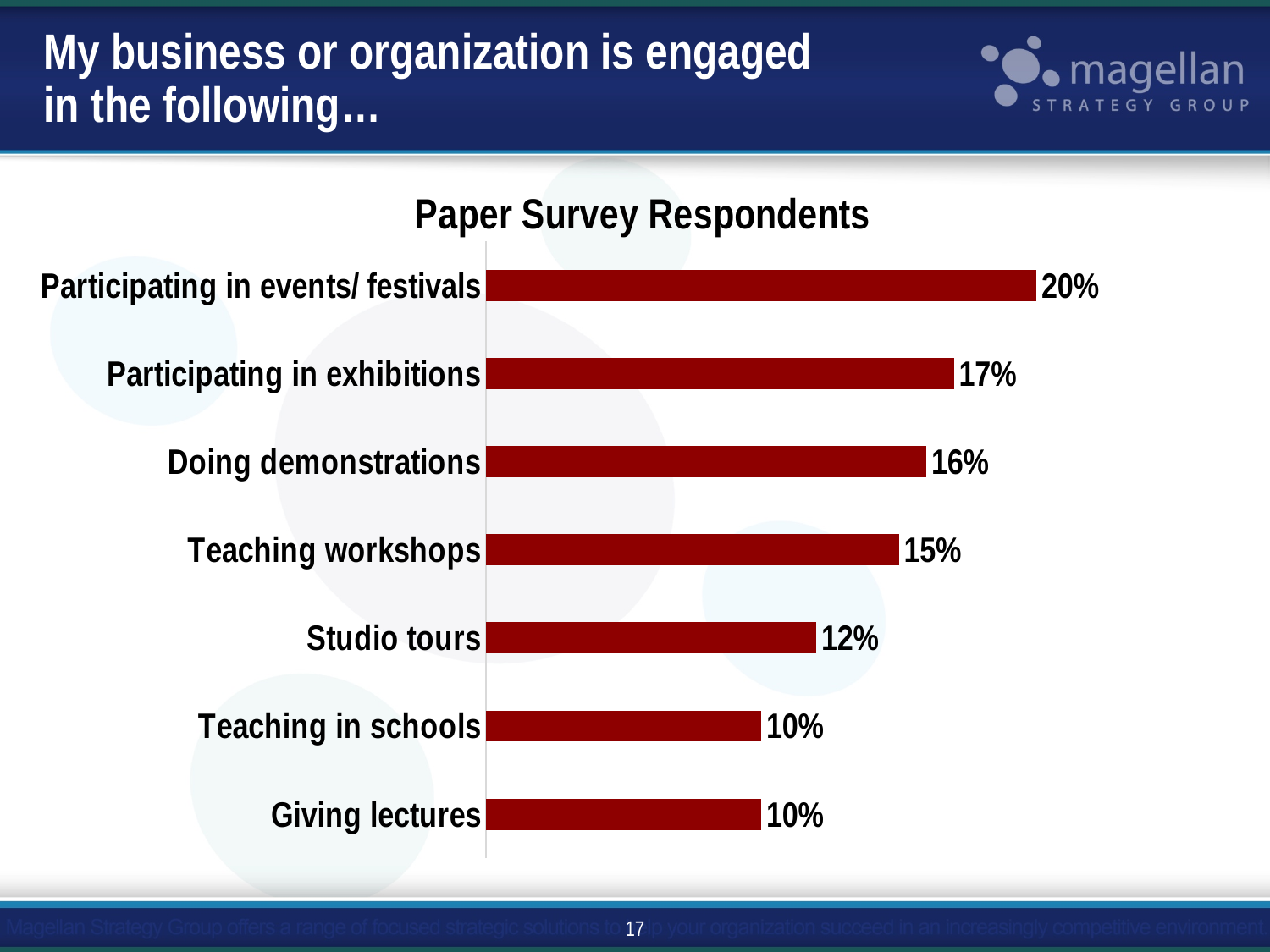
What is the difference between Participating in events/ festivals and Giving lectures? 10% What is the difference between Participating in exhibitions and Teaching workshops? 2% What percentage of paper survey respondents are engaged in participating in events/ festivals? 20% How many categories are shown on the chart? 7 Which category has the highest value? Participating in events/ festivals What is the lowest value shown on the chart? 10% What kind of chart is shown on the slide? Bar chart What is the title of the chart? Paper Survey Respondents Which is larger, Studio tours or Teaching in schools? Studio tours What is the value for Studio tours? 12% Which two categories share the same value of 10%? Teaching in schools and Giving lectures What is the value for Doing demonstrations? 16%